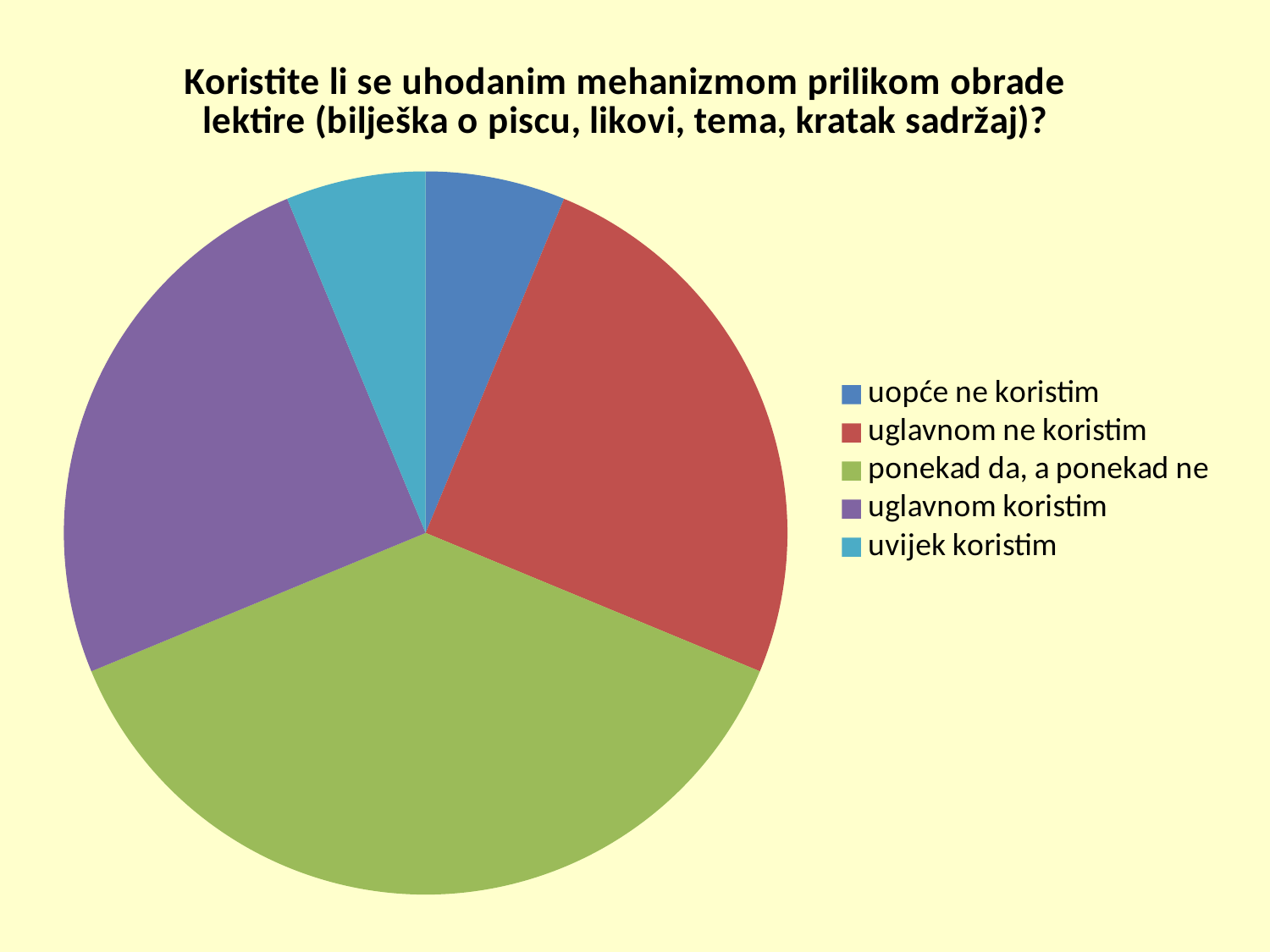
Which slice is larger, "uglavnom ne koristim" or "uopće ne koristim"? uglavnom ne koristim How many categories does the pie chart show? 5 What kind of chart is shown on the slide? pie chart Which category has the largest slice of the pie? ponekad da, a ponekad ne Which slice is larger, "ponekad da, a ponekad ne" or "uvijek koristim"? ponekad da, a ponekad ne Which slice is larger, "ponekad da, a ponekad ne" or "uglavnom ne koristim"? ponekad da, a ponekad ne Which category is shown in green in the pie chart? ponekad da, a ponekad ne What is the title of the chart? Koristite li se uhodanim mehanizmom prilikom obrade lektire (bilješka o piscu, likovi, tema, kratak sadržaj)?